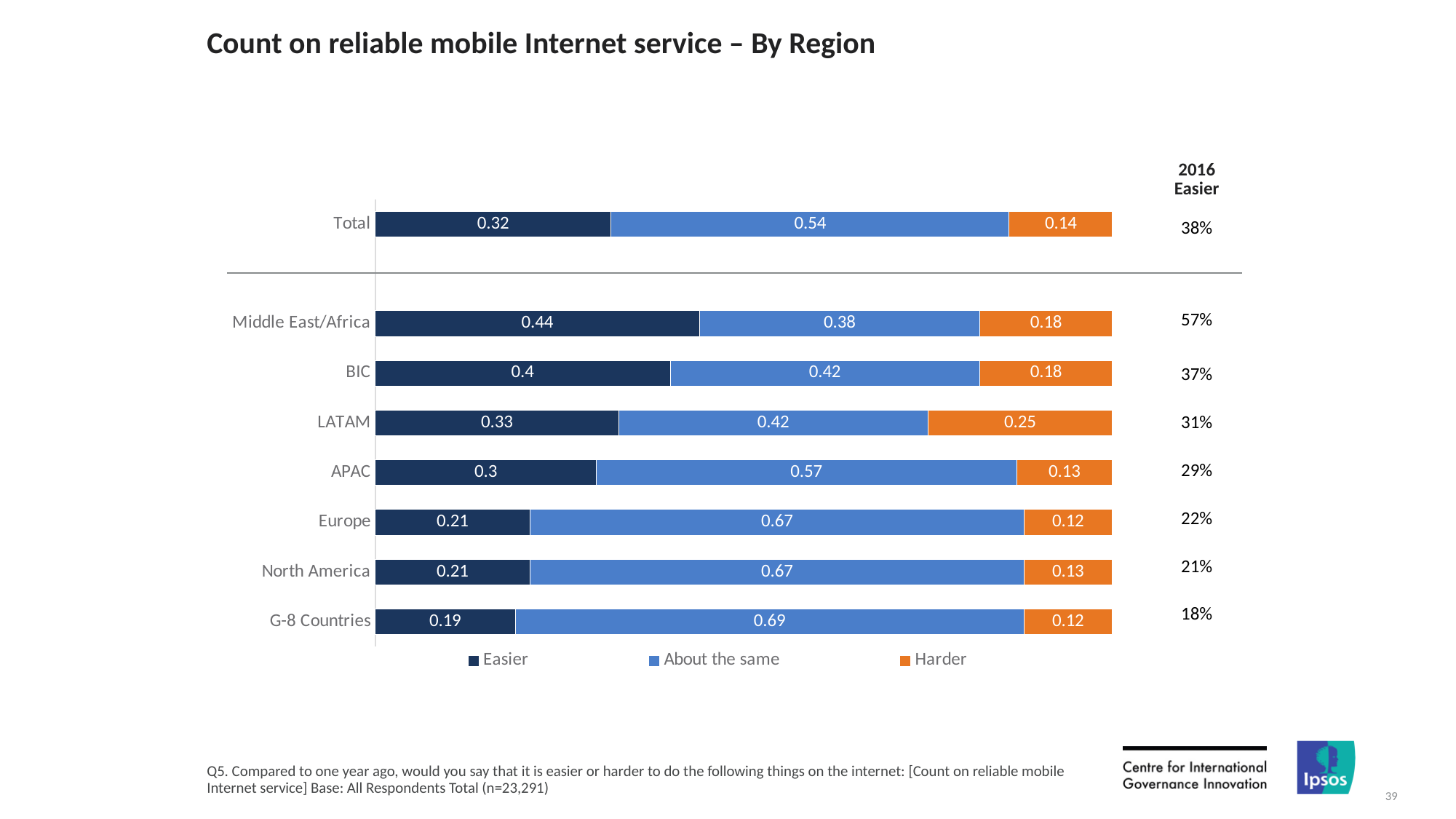
Which region has the highest 'Easier' value? Middle East/Africa What kind of chart is shown on the slide? Stacked bar chart Which is larger, the 'Harder' value for LATAM or for BIC? LATAM Which region has the lowest 'Easier' value? G-8 Countries What is the 'Harder' value for LATAM? 0.25 What is the difference between the 'Easier' values for Middle East/Africa and APAC? 0.14 What is the 2016 Easier percentage shown for Middle East/Africa? 57% How many regions (excluding Total) are shown in the chart? 7 Which colour represents the 'Harder' series in the legend? Orange What is the 'About the same' value for G-8 Countries? 0.69 How many series does the legend list? 3 What is the 'Easier' value for Middle East/Africa? 0.44